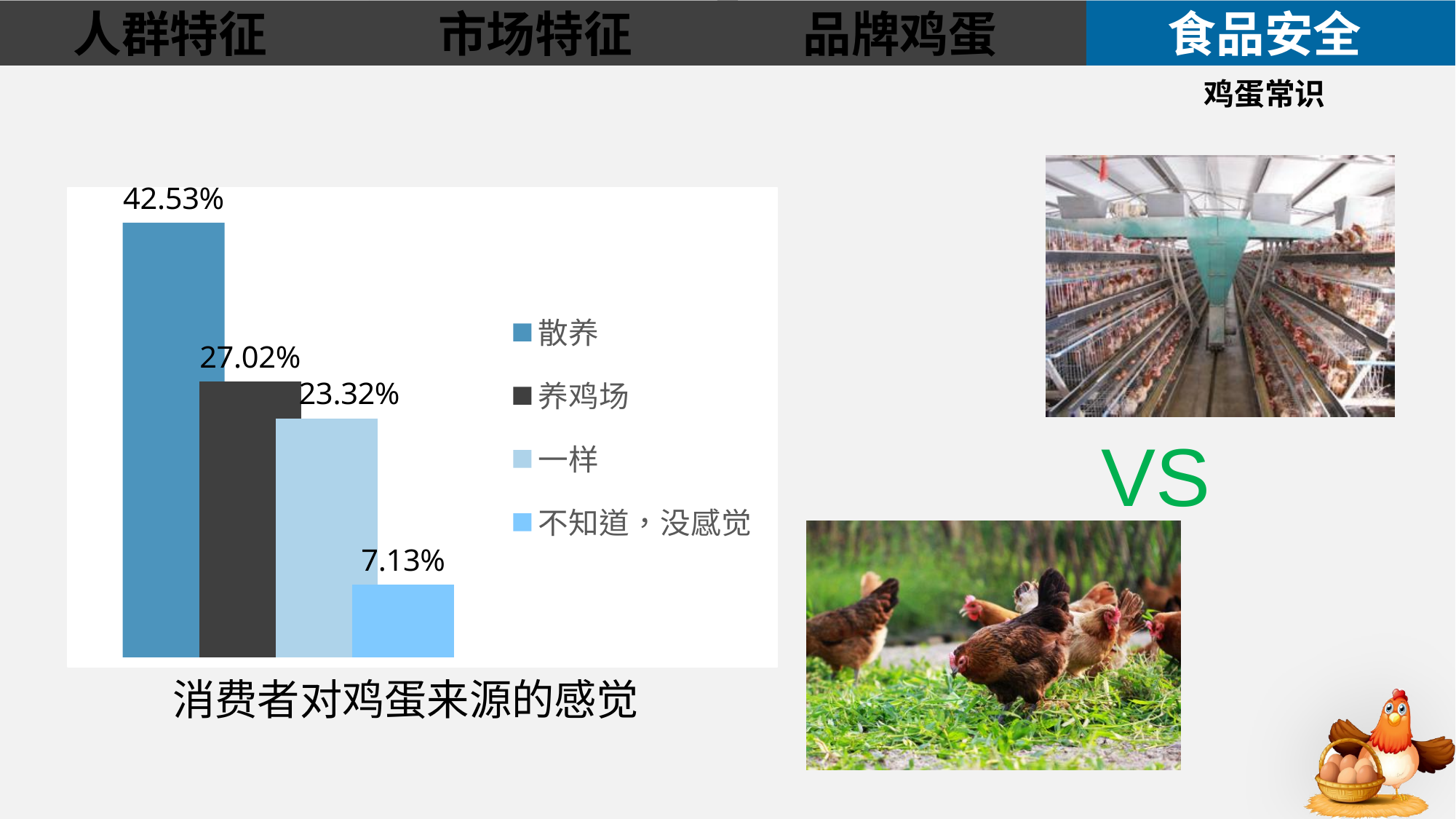
What is the value for 一样 in the chart? 23.32% Which is larger, the value for 养鸡场 or the value for 一样? 养鸡场 What is the difference between the values for 一样 and 不知道，没感觉? 16.19% What is the value for 养鸡场 in the chart? 27.02% What is the title shown below the chart? 消费者对鸡蛋来源的感觉 How many series does the legend list? 4 What is the value for 散养 in the chart? 42.53% What kind of chart is shown on the slide? bar chart What is the value for 不知道，没感觉 in the chart? 7.13% Which category has the highest value in the chart? 散养 Which category has the lowest value in the chart? 不知道，没感觉 What is the difference between the values for 散养 and 养鸡场? 15.51%